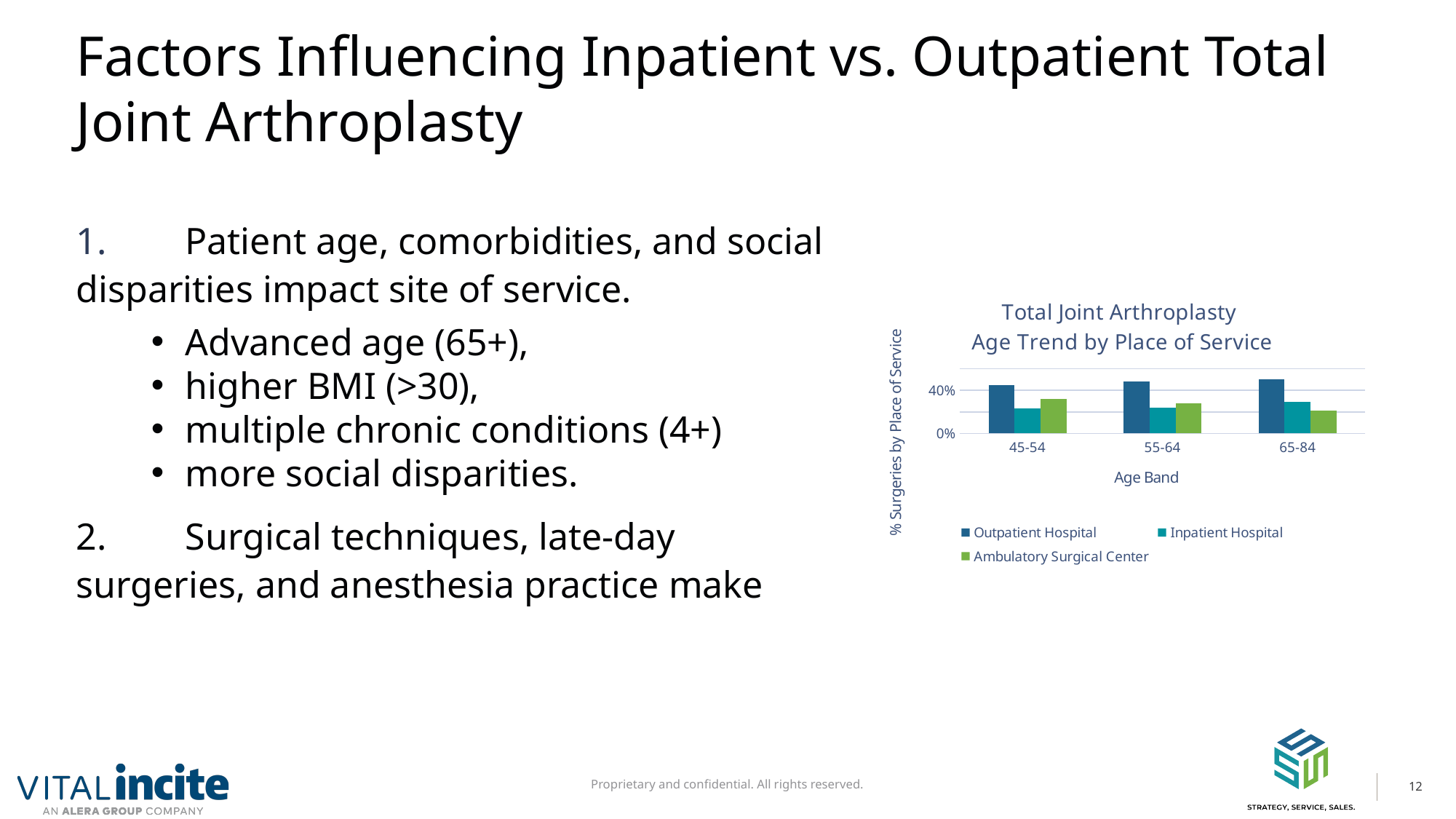
Which place of service has the lowest share in the 65-84 age band? Ambulatory Surgical Center Is the value for Outpatient Hospital in the 45-54 age band greater or less than 40%? greater How many age bands are shown on the x axis of the chart? 3 What is the title of the chart? Total Joint Arthroplasty Age Trend by Place of Service In the 45-54 age band, which is larger: Inpatient Hospital or Ambulatory Surgical Center? Ambulatory Surgical Center Is the value for Inpatient Hospital in the 55-64 age band greater or less than 40%? less What is the label of the chart's x axis? Age Band Do the Ambulatory Surgical Center values rise or fall across the age bands from 45-54 to 65-84? fall How many series does the chart's legend list? 3 Which place of service has the lowest share in the 45-54 age band? Inpatient Hospital Which place of service has the highest share in the 65-84 age band? Outpatient Hospital What kind of chart is shown on the slide? Bar chart